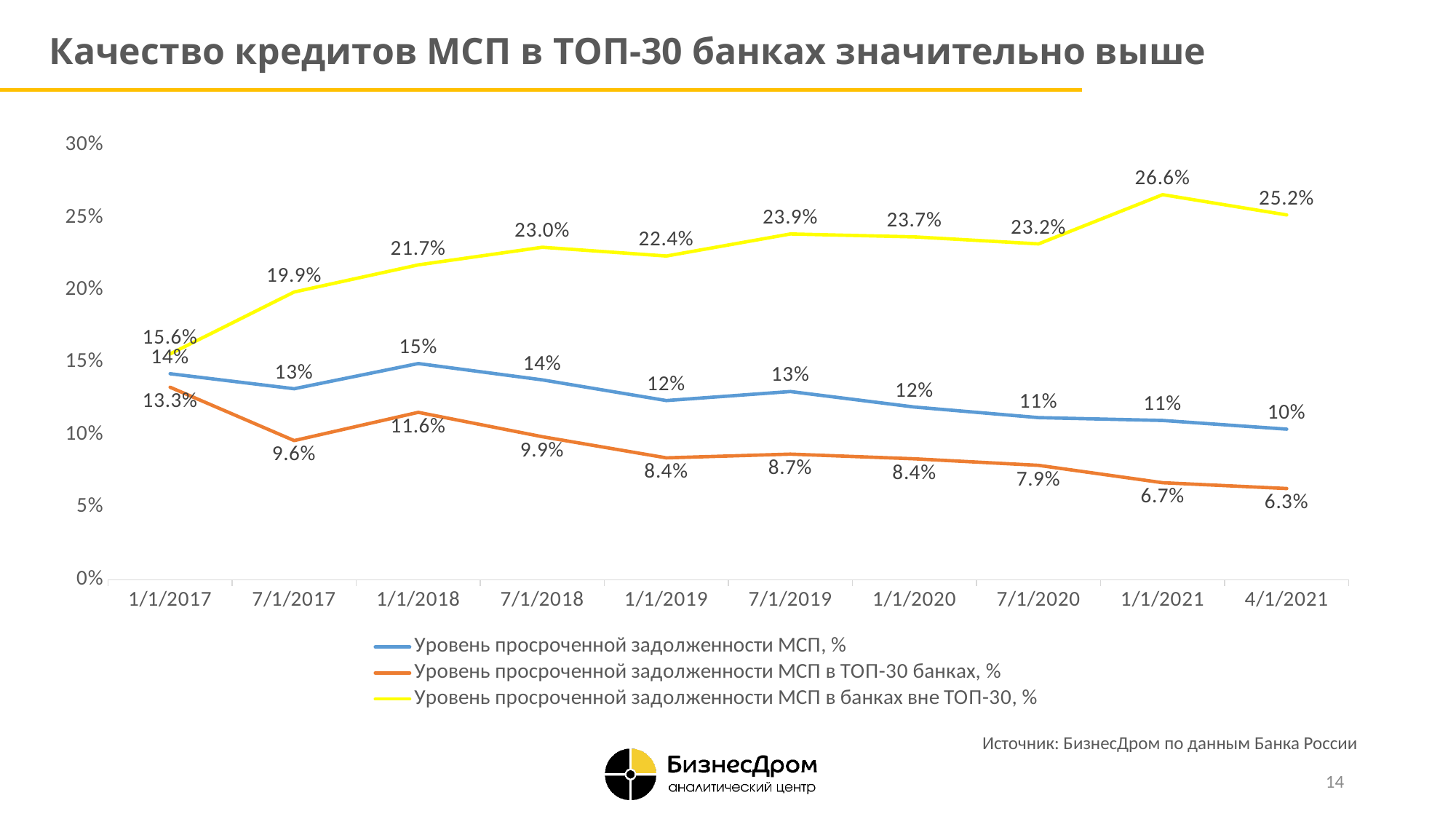
At 4/1/2021, what is the difference between the value for banks outside the TOP-30 (25.2%) and the value for TOP-30 banks (6.3%)? 18.9 percentage points At which date does the series 'Уровень просроченной задолженности МСП в ТОП-30 банках, %' reach its lowest value? 4/1/2021 What is the value of the series 'Уровень просроченной задолженности МСП в ТОП-30 банках, %' at 7/1/2017? 9.6% How many series does the legend list? 3 What is the value of the series 'Уровень просроченной задолженности МСП в банках вне ТОП-30, %' at 1/1/2021? 26.6% How many dates are shown on the x axis of the chart? 10 At which date does the series 'Уровень просроченной задолженности МСП в банках вне ТОП-30, %' reach its highest value? 1/1/2021 What is the value of the series 'Уровень просроченной задолженности МСП, %' at 1/1/2018? 15% Does the series 'Уровень просроченной задолженности МСП в ТОП-30 банках, %' generally rise or fall from 1/1/2017 to 4/1/2021? Fall At 1/1/2017, which is larger: the value for banks outside the TOP-30 or the value for TOP-30 banks? Banks outside the TOP-30 (15.6%) Is the value for banks outside the TOP-30 at 7/1/2018 greater or less than 20%? greater What kind of chart is shown on the slide? Line chart